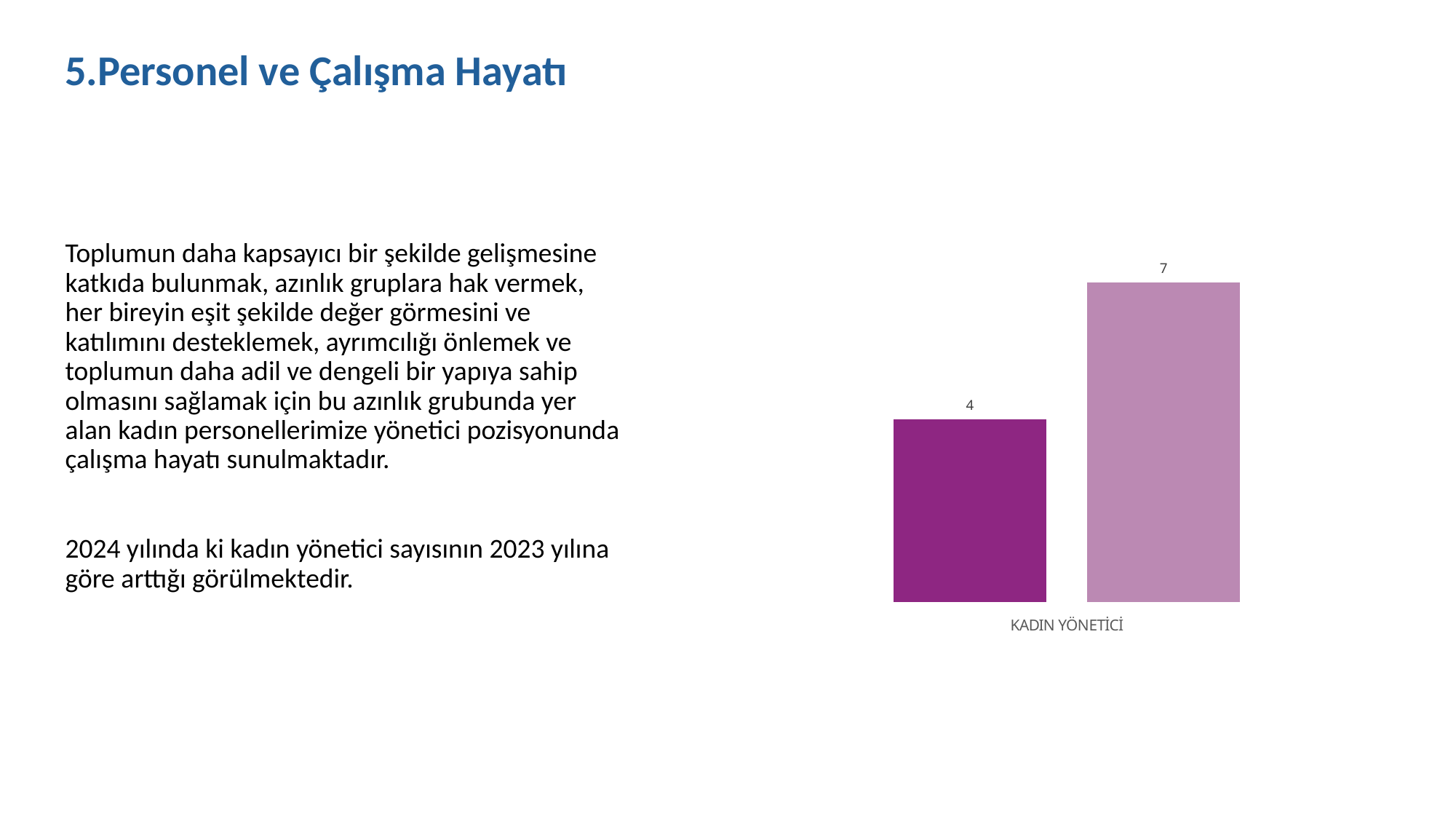
What is the difference between the values of the two bars in the chart? 3 What is the category label shown beneath the bars on the x axis? KADIN YÖNETİCİ How many bars are plotted in the chart? 2 Which bar has the larger value, the left one or the right one? The right one What is the value shown on the right (lighter purple) bar of the chart? 7 Which bar in the chart is the tallest? The right (lighter purple) bar, with 7 What is the value shown on the left (darker purple) bar of the chart? 4 Do the bar values rise or fall from left to right in the chart? Rise What type of chart is shown on the slide? Bar chart What colour is the taller bar in the chart? Light purple Which bar in the chart is the shortest? The left (darker purple) bar, with 4